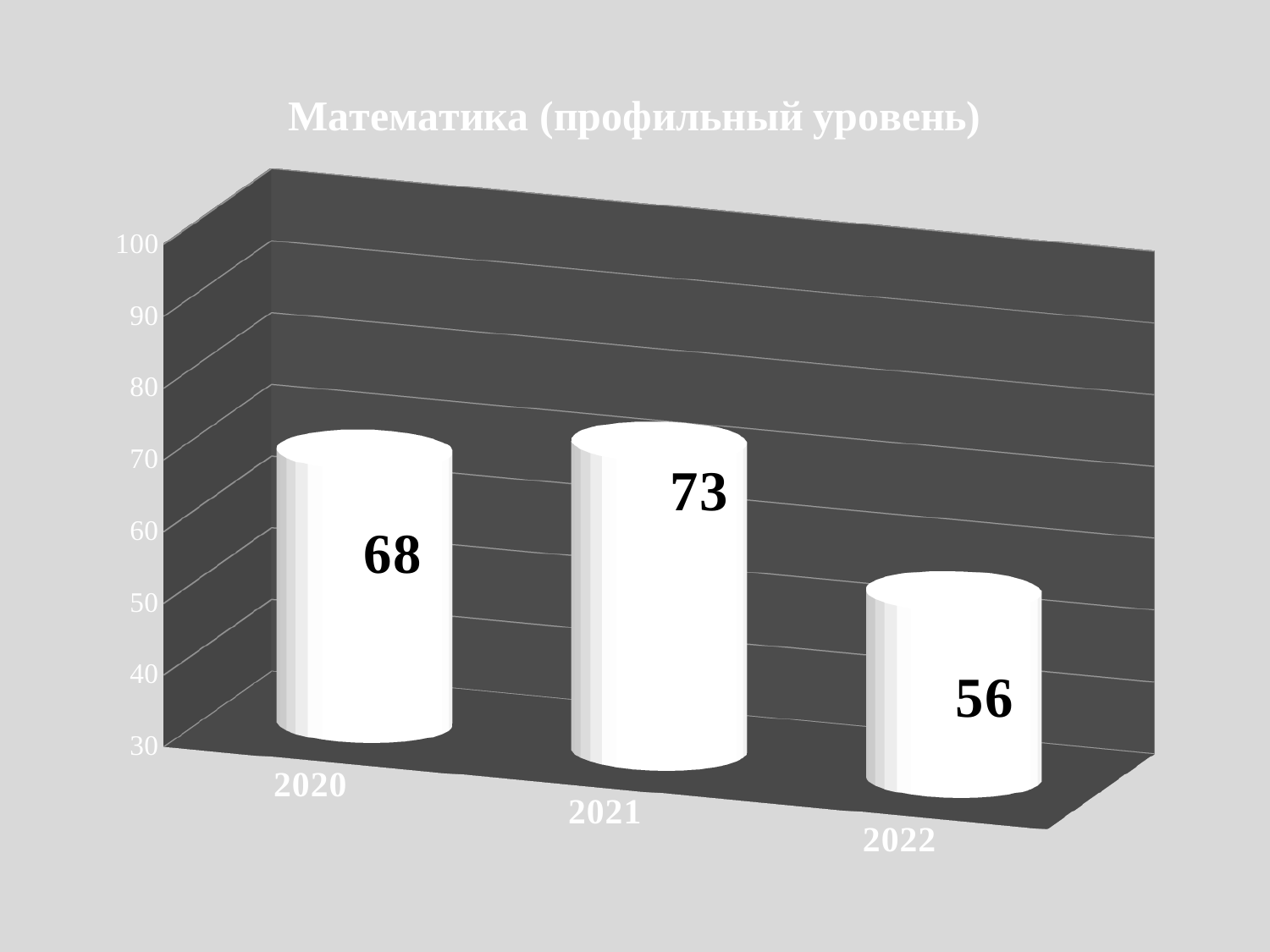
What is the difference between the values for 2021 and 2022? 17 Which is larger, the value for 2020 or the value for 2022? 2020 Which year has the highest value? 2021 What is the value for 2022? 56 What is the value for 2021? 73 What kind of chart is this? bar chart How many years are shown on the chart? 3 What is the difference between the values for 2021 and 2020? 5 What is the title of the chart? Математика (профильный уровень) Which year has the lowest value? 2022 Is the value for 2022 greater or less than 60? less What is the value for 2020? 68